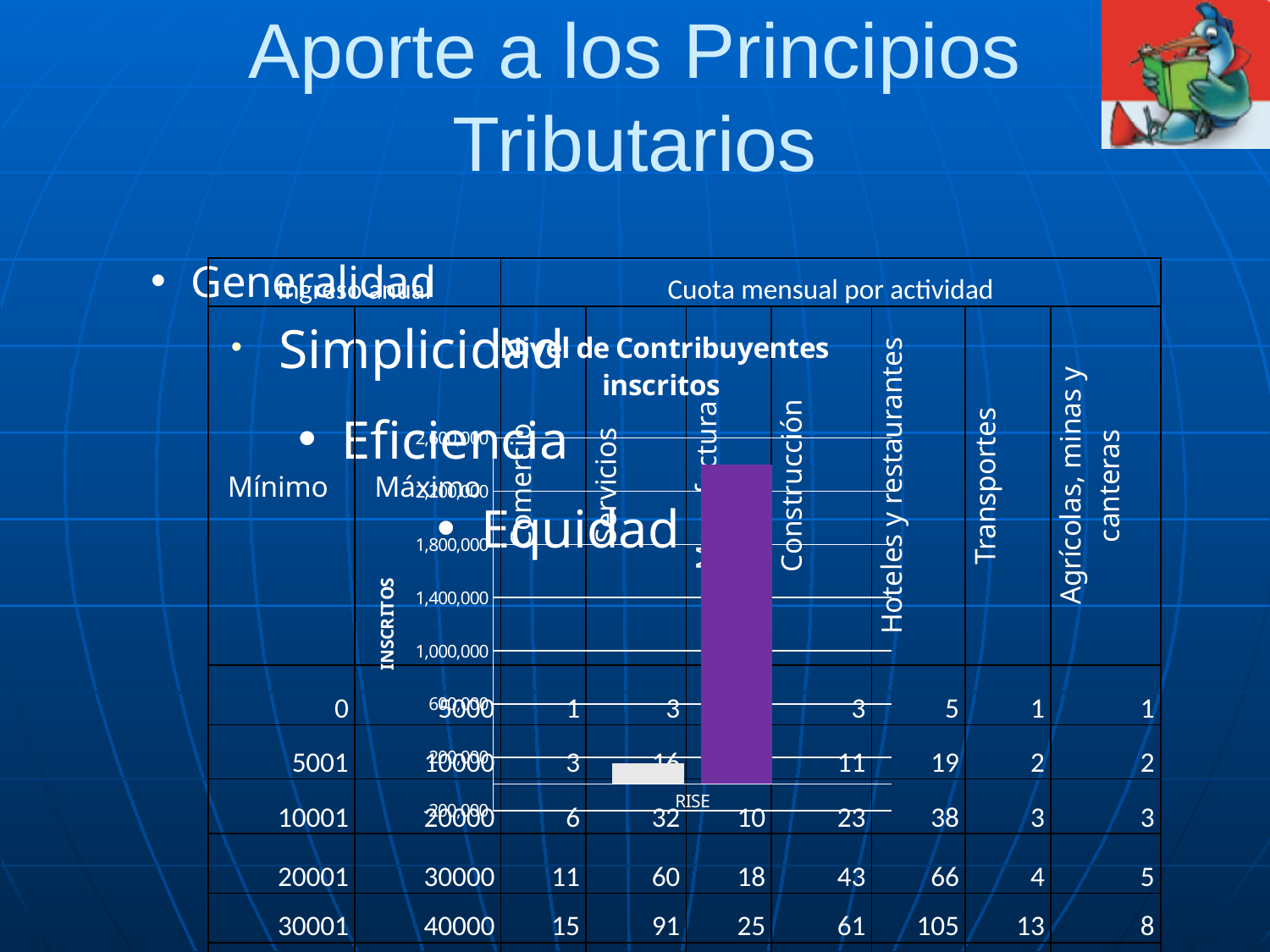
What is the highest tick value shown on the chart's vertical axis? 2,600,000 How many categories are shown on the chart's x axis? 1 Is the value of the purple bar greater or less than 2,600,000? less What label is shown on the chart's vertical axis? INSCRITOS Is the value of the purple bar greater or less than 1,800,000? greater Is the value of the white bar greater or less than 1,000,000? less Which bar is taller, the purple bar or the white bar? the purple bar What is the title of the chart? Nivel de Contribuyentes inscritos What kind of chart is shown on the slide? bar chart